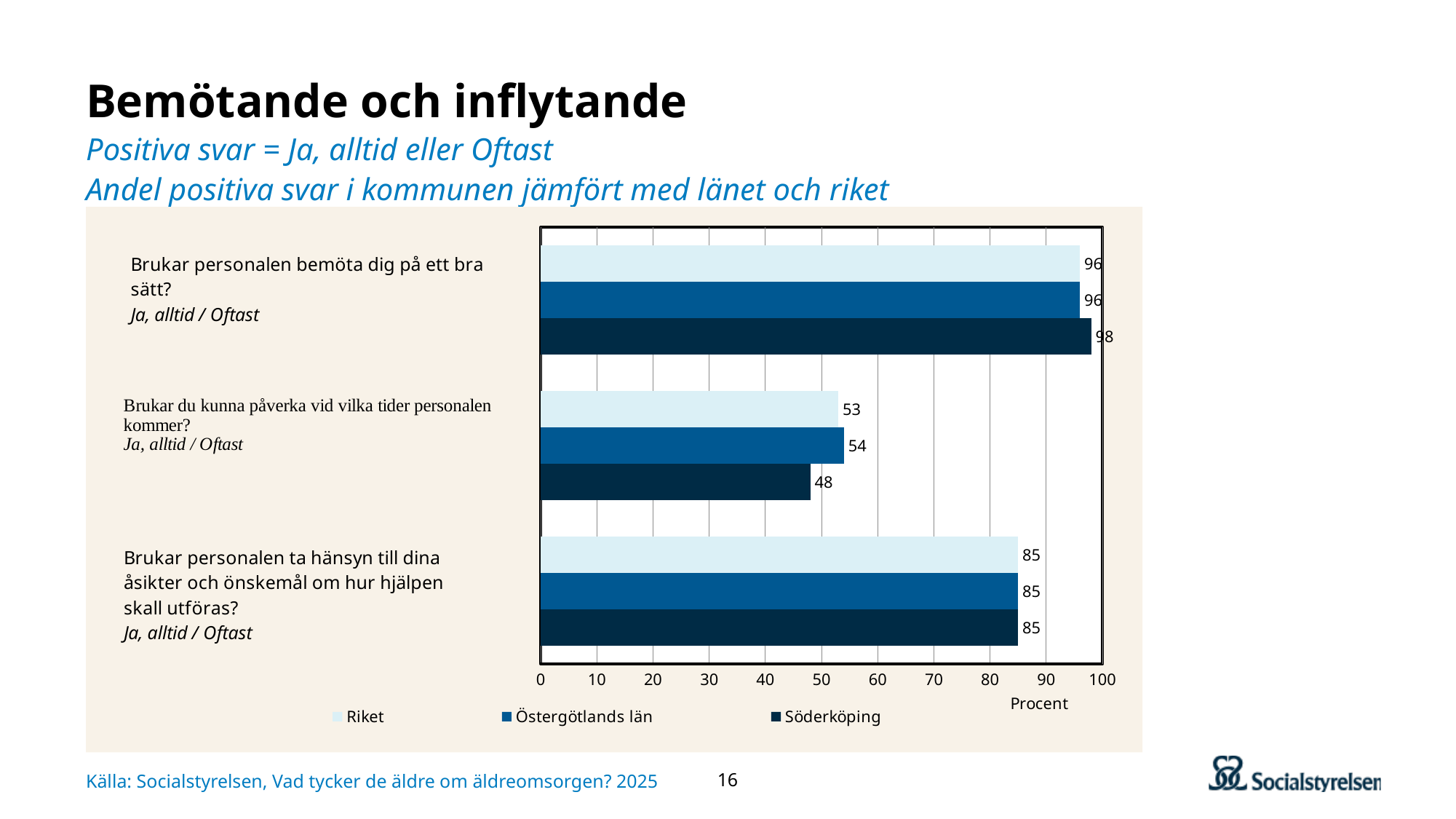
How many questions (categories) are shown in the chart? 3 Which is larger on the question "Brukar personalen bemöta dig på ett bra sätt?": Riket or Söderköping? Söderköping How many series does the legend list? 3 What is the value for Söderköping on the question "Brukar personalen bemöta dig på ett bra sätt?"? 98 What is the value for Riket on the question "Brukar du kunna påverka vid vilka tider personalen kommer?"? 53 Which question has the lowest value for Söderköping? Brukar du kunna påverka vid vilka tider personalen kommer? What is the value for Söderköping on the question "Brukar du kunna påverka vid vilka tider personalen kommer?"? 48 What is the value for Östergötlands län on the question "Brukar personalen ta hänsyn till dina åsikter och önskemål om hur hjälpen skall utföras?"? 85 Which question has the highest value for Riket? Brukar personalen bemöta dig på ett bra sätt? What is the difference between Östergötlands län and Söderköping on the question "Brukar du kunna påverka vid vilka tider personalen kommer?"? 6 What kind of chart is shown on the slide? Bar chart What is the label of the x axis? Procent